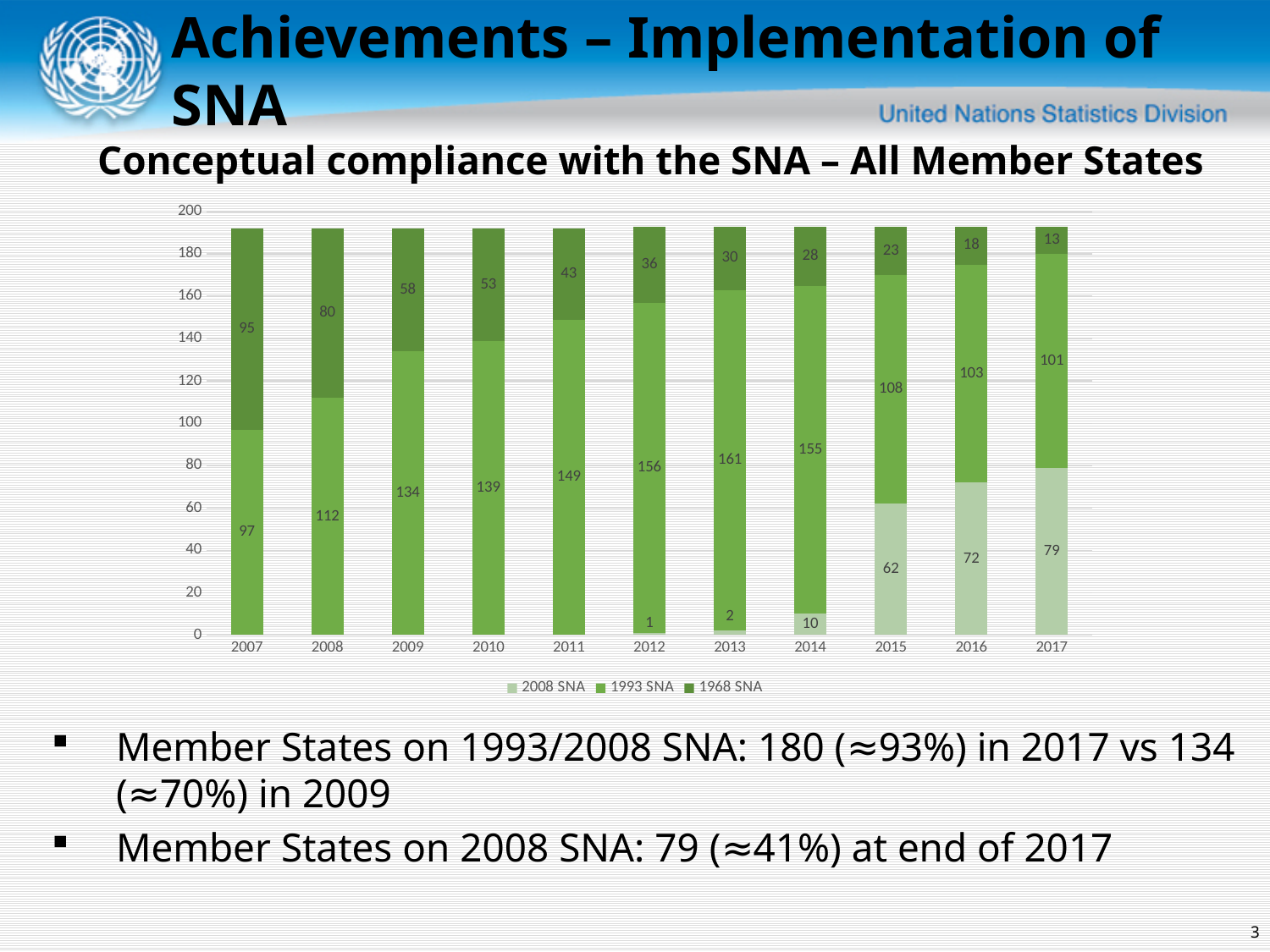
In which year is the 1993 SNA value highest? 2013 How many series does the legend list? 3 In which year is the 1968 SNA value lowest? 2017 What is the value for 1968 SNA in 2007? 95 What type of chart is shown on the slide? Stacked bar chart What is the difference between the 1968 SNA values in 2007 and 2017? 82 What is the total of the stacked bar for 2017? 193 Which is larger, the 2008 SNA value in 2015 or the 2008 SNA value in 2016? 2016 How many years are shown on the x axis? 11 What is the value for 2008 SNA in 2017? 79 Does the 1968 SNA value rise or fall from 2007 to 2017? Fall What is the value for 1993 SNA in 2009? 134